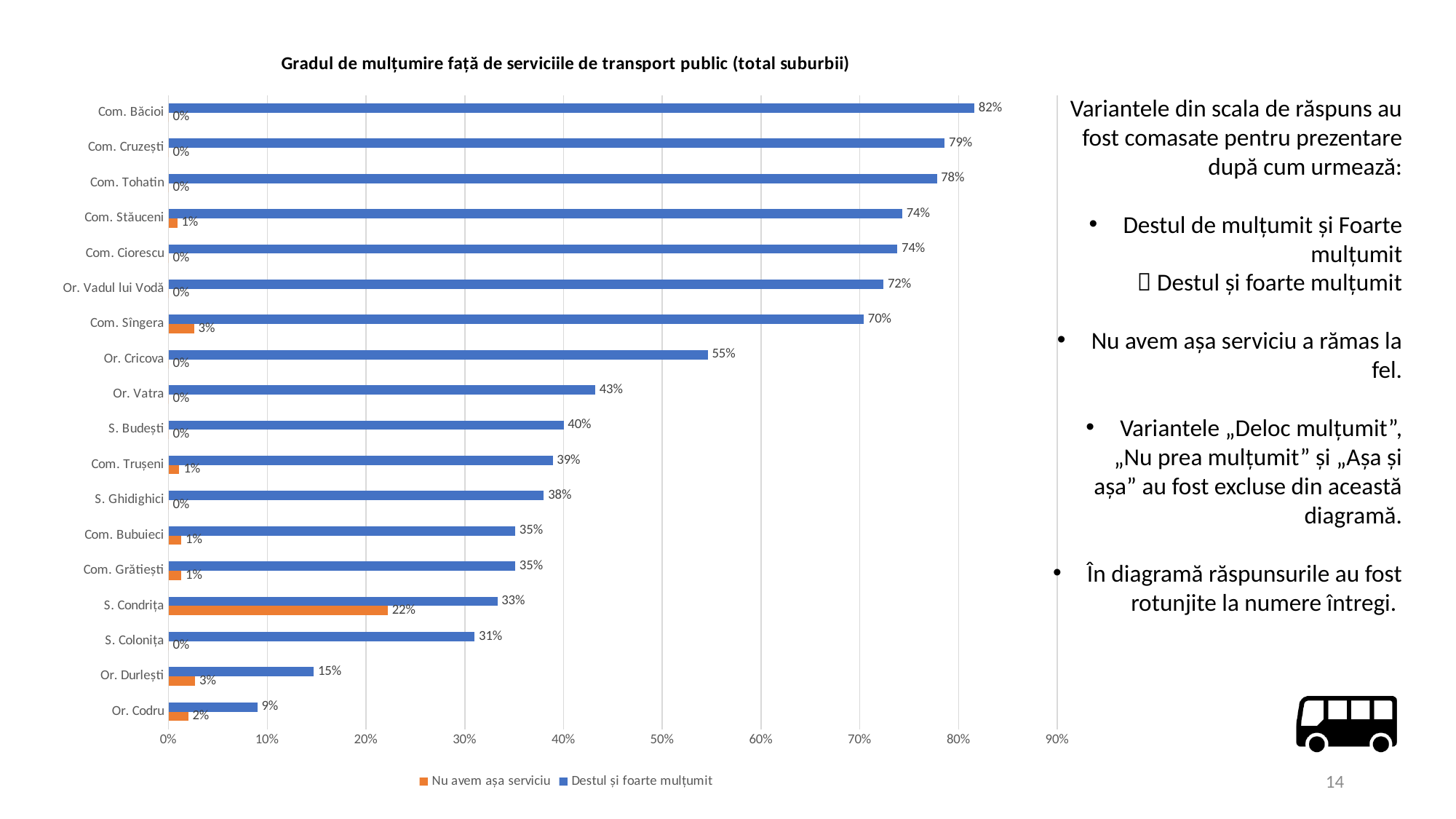
What is the title of the chart? Gradul de mulțumire față de serviciile de transport public (total suburbii) Which has a larger "Destul și foarte mulțumit" value, Com. Sîngera or S. Budești? Com. Sîngera How many categories are shown on the chart? 18 What is the value of "Destul și foarte mulțumit" for Or. Cricova? 55% Which category has the highest value for "Destul și foarte mulțumit"? Com. Băcioi Which category has the highest value for "Nu avem așa serviciu"? S. Condrița How many series does the legend list? 2 What is the difference between the "Destul și foarte mulțumit" values for Com. Cruzești and Or. Vatra? 36% What is the value of "Nu avem așa serviciu" for S. Condrița? 22% What kind of chart is shown on the slide? Bar chart What is the value of "Destul și foarte mulțumit" for Com. Băcioi? 82% Which category has the lowest value for "Destul și foarte mulțumit"? Or. Codru